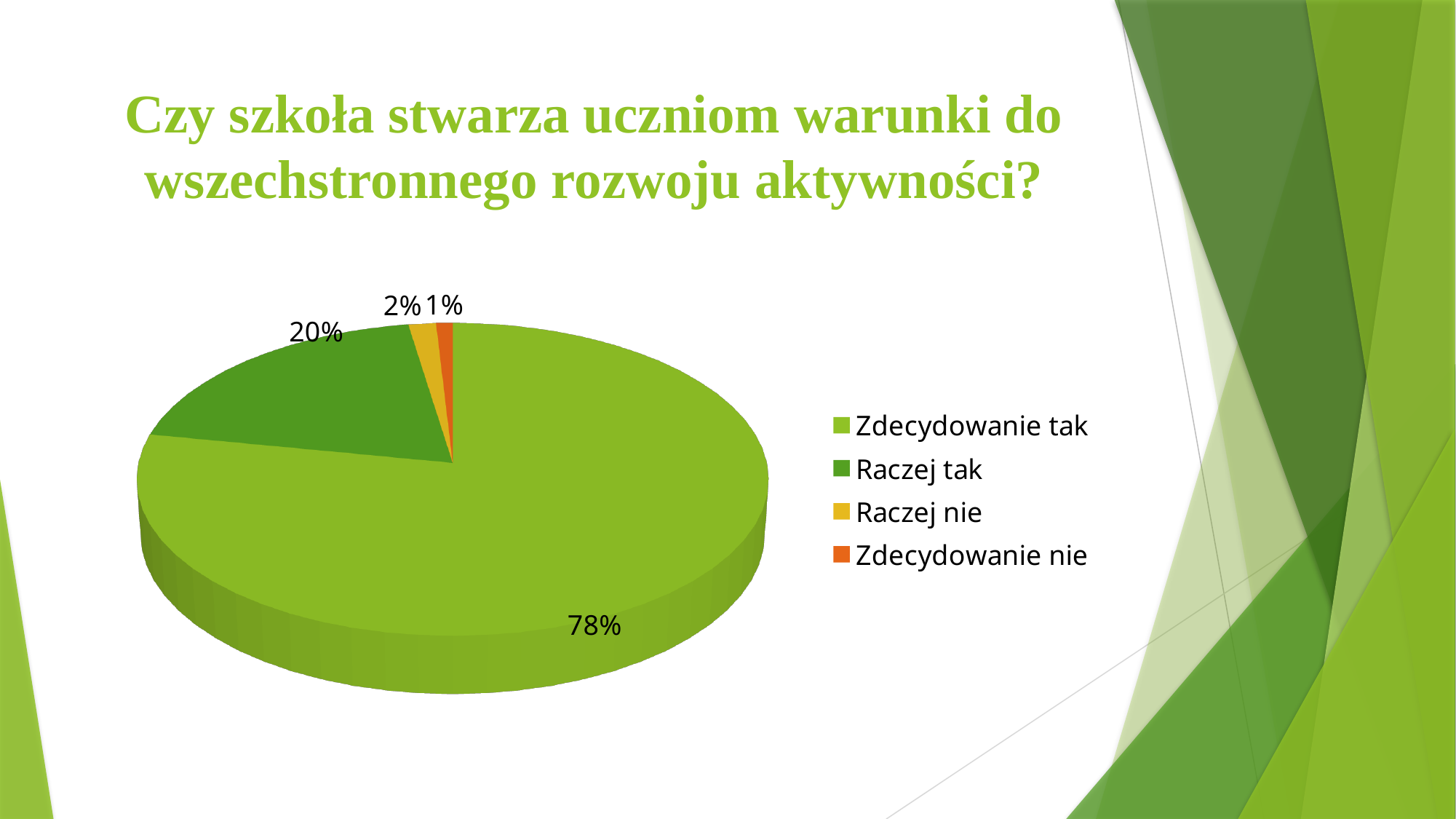
What is the difference in percentage points between "Zdecydowanie tak" and "Raczej tak"? 58 What is the title of the slide above the chart? Czy szkoła stwarza uczniom warunki do wszechstronnego rozwoju aktywności? What share of the pie is labelled "Zdecydowanie tak"? 78% What share of the pie is labelled "Raczej nie"? 2% Which is larger, the slice for "Raczej tak" or the slice for "Raczej nie"? Raczej tak Which category has the smallest slice of the pie? Zdecydowanie nie What share of the pie is labelled "Raczej tak"? 20% What colour is the slice for "Zdecydowanie nie"? orange How many categories does the legend list? 4 What kind of chart is shown on the slide? pie chart Which category has the largest slice of the pie? Zdecydowanie tak